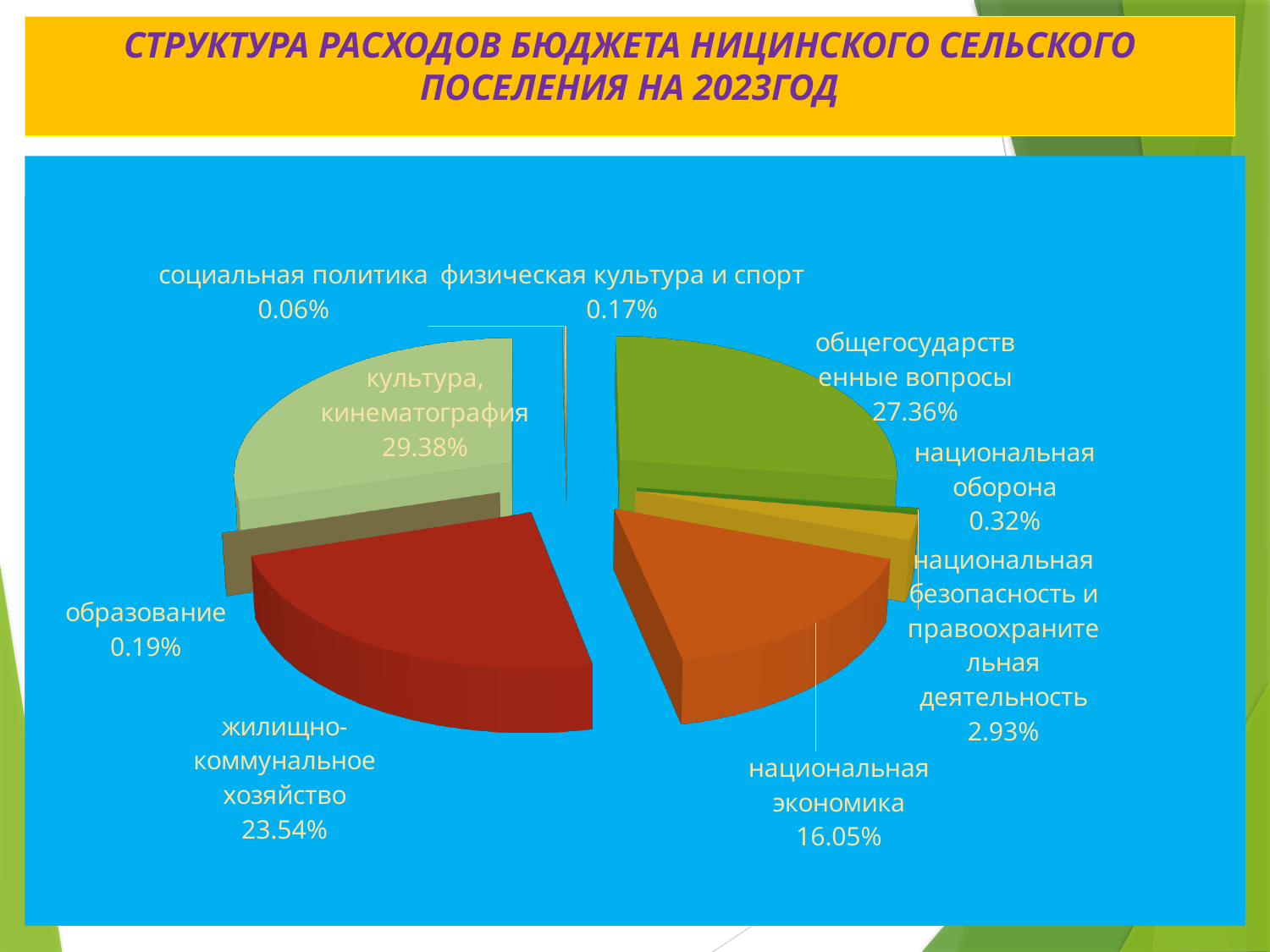
What is the value for жилищно-коммунальное хозяйство? 23.54% Which category has the largest share of the budget expenditures? культура, кинематография What is the difference between the shares of культура, кинематография and общегосударственные вопросы? 2.02% How many categories are shown in the pie chart? 9 What is the value shown for общегосударственные вопросы? 27.36% Which is larger: the share for жилищно-коммунальное хозяйство or for национальная экономика? жилищно-коммунальное хозяйство What is the title of the slide? СТРУКТУРА РАСХОДОВ БЮДЖЕТА НИЦИНСКОГО СЕЛЬСКОГО ПОСЕЛЕНИЯ НА 2023ГОД What kind of chart is shown on the slide? pie chart What share is shown for национальная безопасность и правоохранительная деятельность? 2.93% What share of the budget expenditures goes to культура, кинематография? 29.38% Which category has the smallest share of the budget expenditures? социальная политика What percentage is shown for национальная экономика? 16.05%